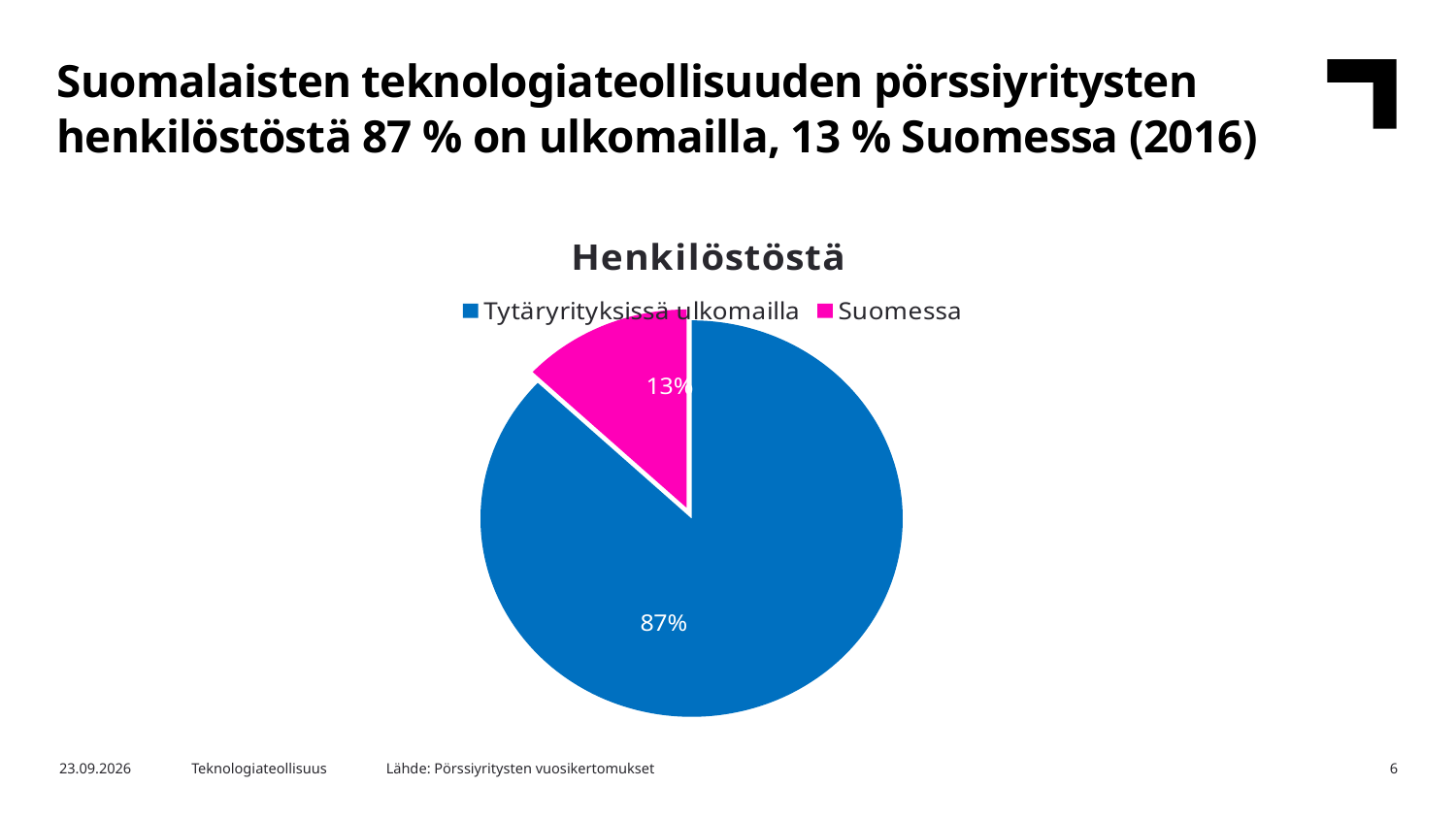
What is the title of the chart? Henkilöstöstä Which slice is the smallest in the pie chart? Suomessa Which is larger, the 'Suomessa' slice or the 'Tytäryrityksissä ulkomailla' slice? Tytäryrityksissä ulkomailla How many entries does the legend list? 2 How many slices does the pie chart have? 2 Which slice is the largest in the pie chart? Tytäryrityksissä ulkomailla What share of the pie does the 'Suomessa' slice represent? 13% What colour is the 'Suomessa' slice? Magenta (pink) What is the difference in percentage points between the 'Tytäryrityksissä ulkomailla' and 'Suomessa' slices? 74 percentage points What kind of chart is shown on the slide? Pie chart What share of the pie does the 'Tytäryrityksissä ulkomailla' slice represent? 87%